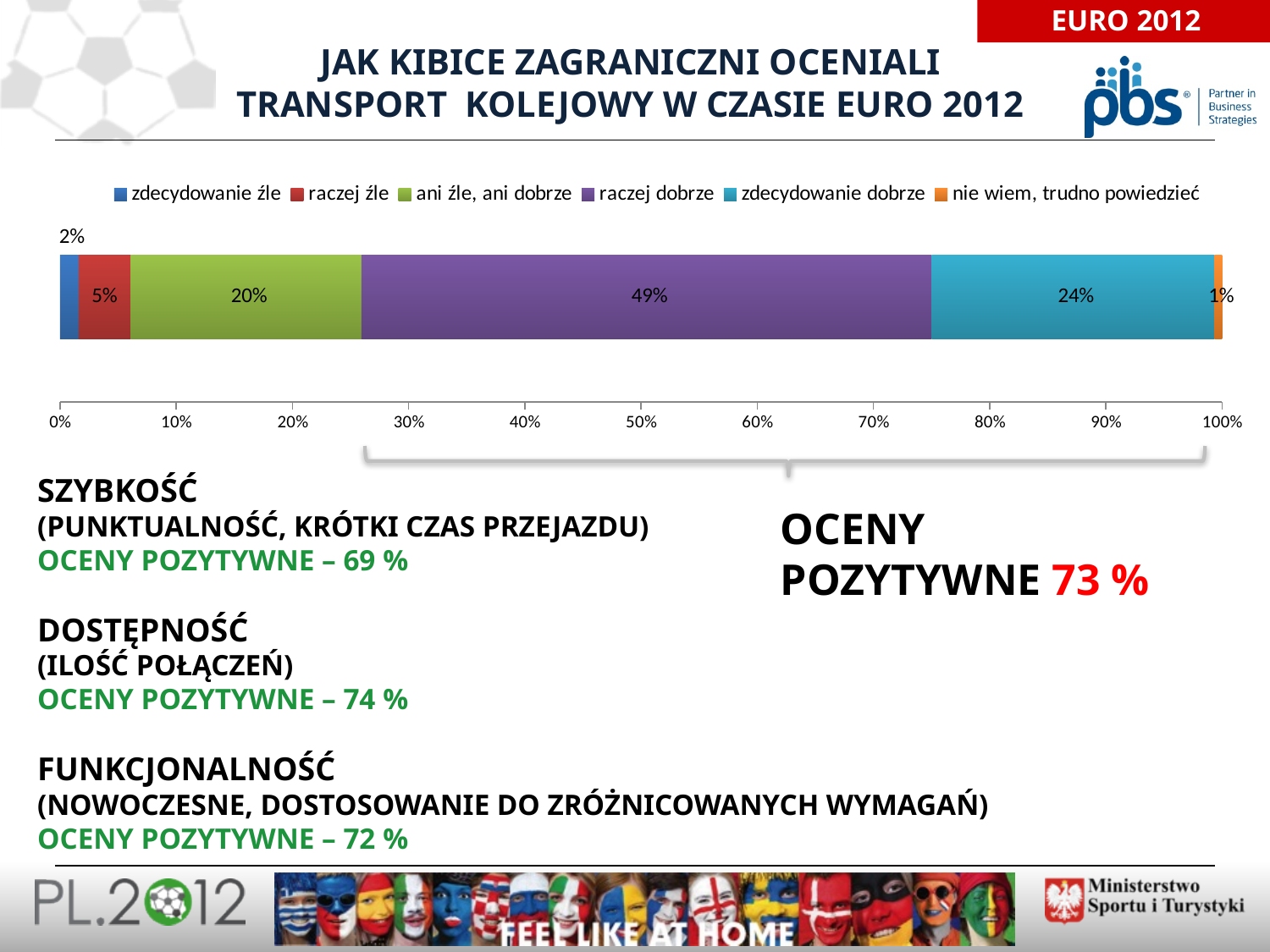
How many series does the legend list? 6 What is the value for "nie wiem, trudno powiedzieć"? 1% Which is larger, the value for "ani źle, ani dobrze" or the value for "raczej źle"? ani źle, ani dobrze What is the value for "zdecydowanie dobrze"? 24% Which response category has the lowest value? nie wiem, trudno powiedzieć What is the value for "ani źle, ani dobrze"? 20% What is the value for "raczej dobrze"? 49% What is the difference between the values for "raczej dobrze" and "zdecydowanie dobrze"? 25% Which response category has the highest value? raczej dobrze What is the value for "raczej źle"? 5% What kind of chart is shown on the slide? stacked bar chart What is the value for "zdecydowanie źle"? 2%